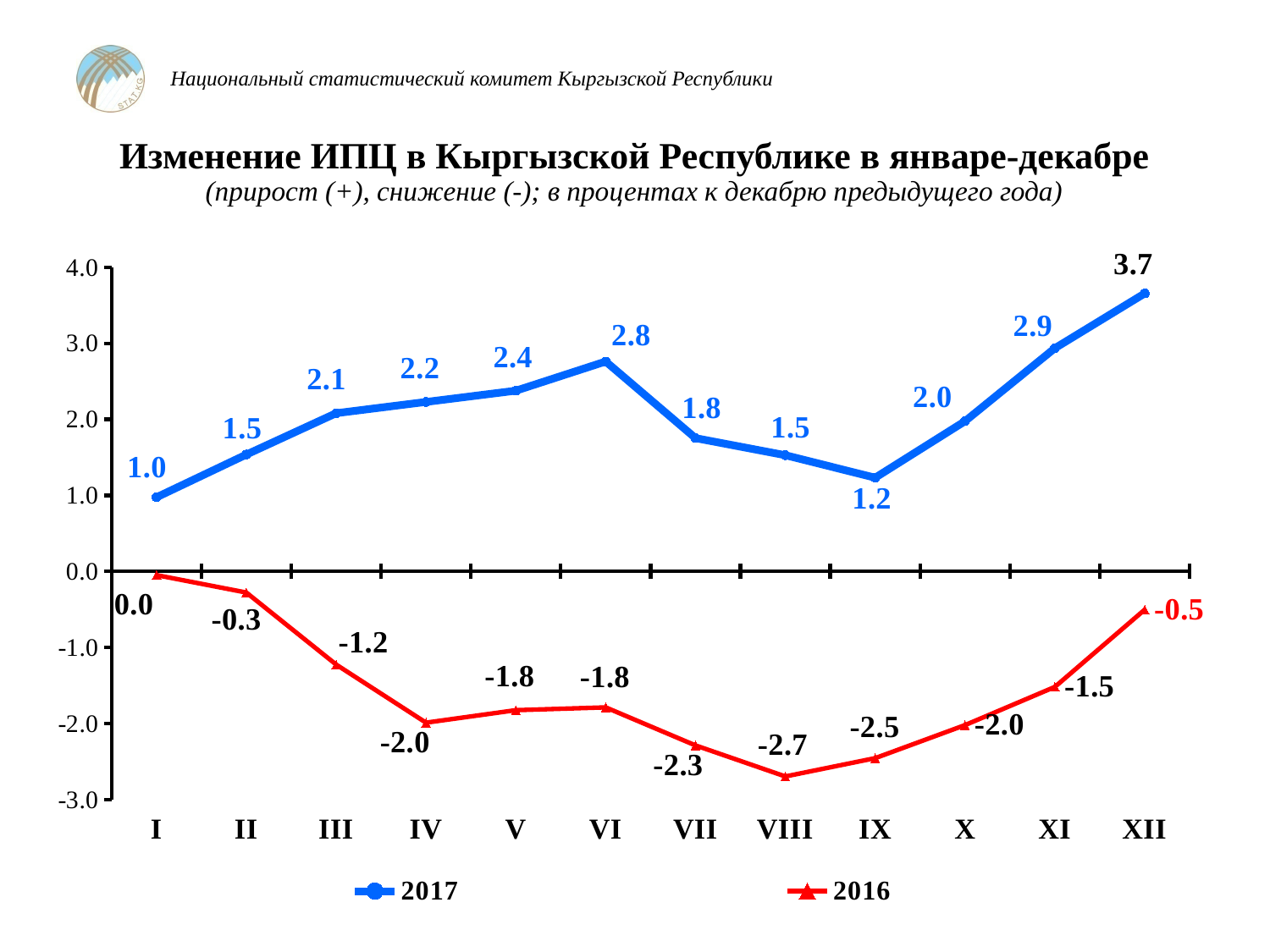
Which colour is used for the 2016 series? red What kind of chart is shown on the slide? line chart What is the value for 2017 in month VI? 2.8 What is the value for 2017 in month XII? 3.7 How many series does the legend list? 2 What is the difference between the 2017 and 2016 values in month XII? 4.2 In which month is the 2016 series at its lowest? VIII In which month is the 2017 series at its highest? XII In which month is the 2017 series at its lowest? I Which series has the larger value in month IX, 2017 or 2016? 2017 How many months are shown on the x axis? 12 What is the value for 2016 in month VIII? -2.7